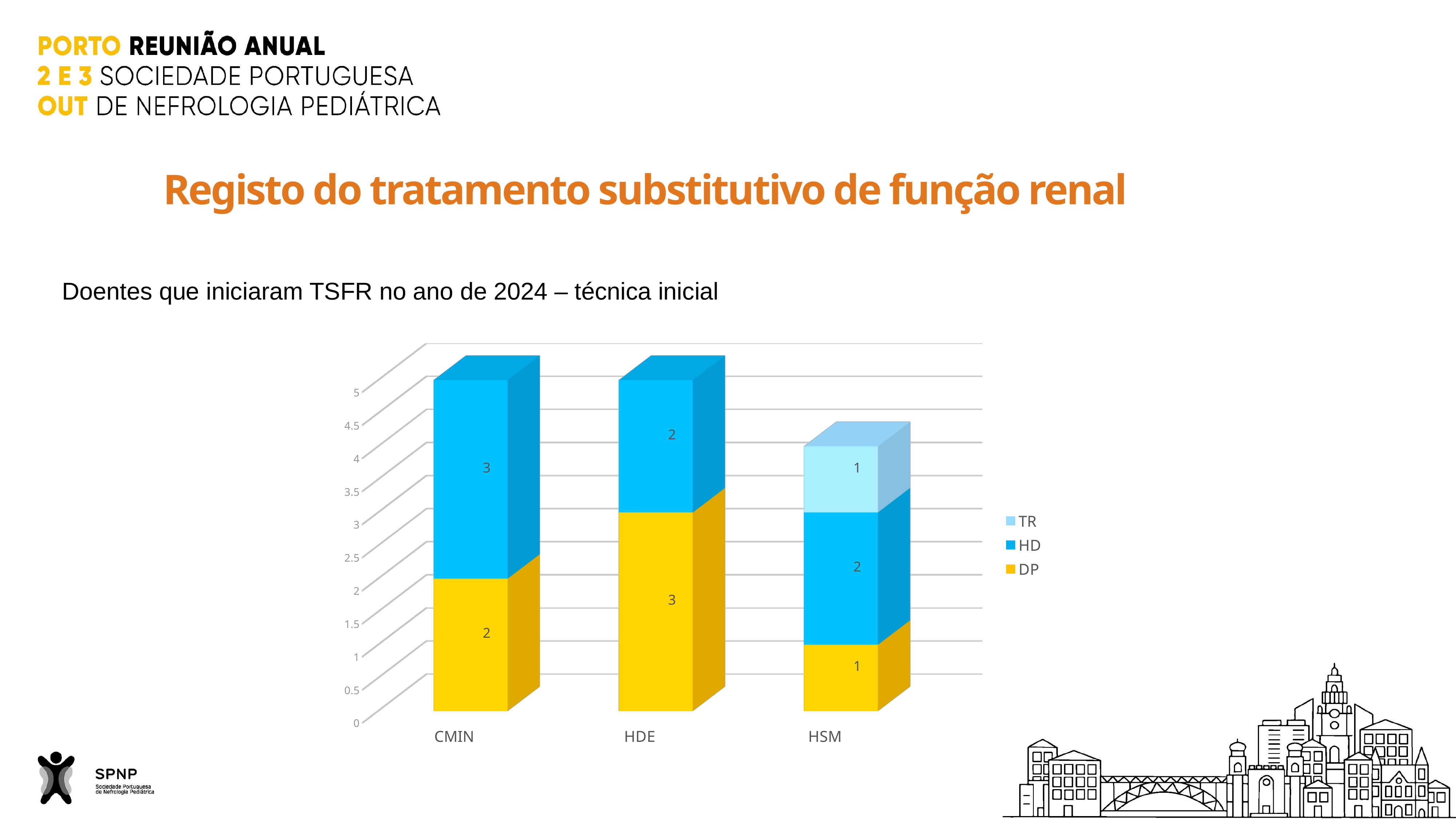
How many series does the legend list? 3 What is the total of the stacked bar for HSM? 4 How many categories are shown on the x axis? 3 What is the difference between the HD value for CMIN and the HD value for HSM? 1 Which category has the highest DP value? HDE Which is larger, the DP value for HDE or the DP value for CMIN? HDE Which category has the lowest DP value? HSM What kind of chart is shown on the slide? Stacked bar chart What is the TR value for HSM? 1 What is the DP value for CMIN? 2 What is the HD value for HDE? 2 What is the HD value for HSM? 2